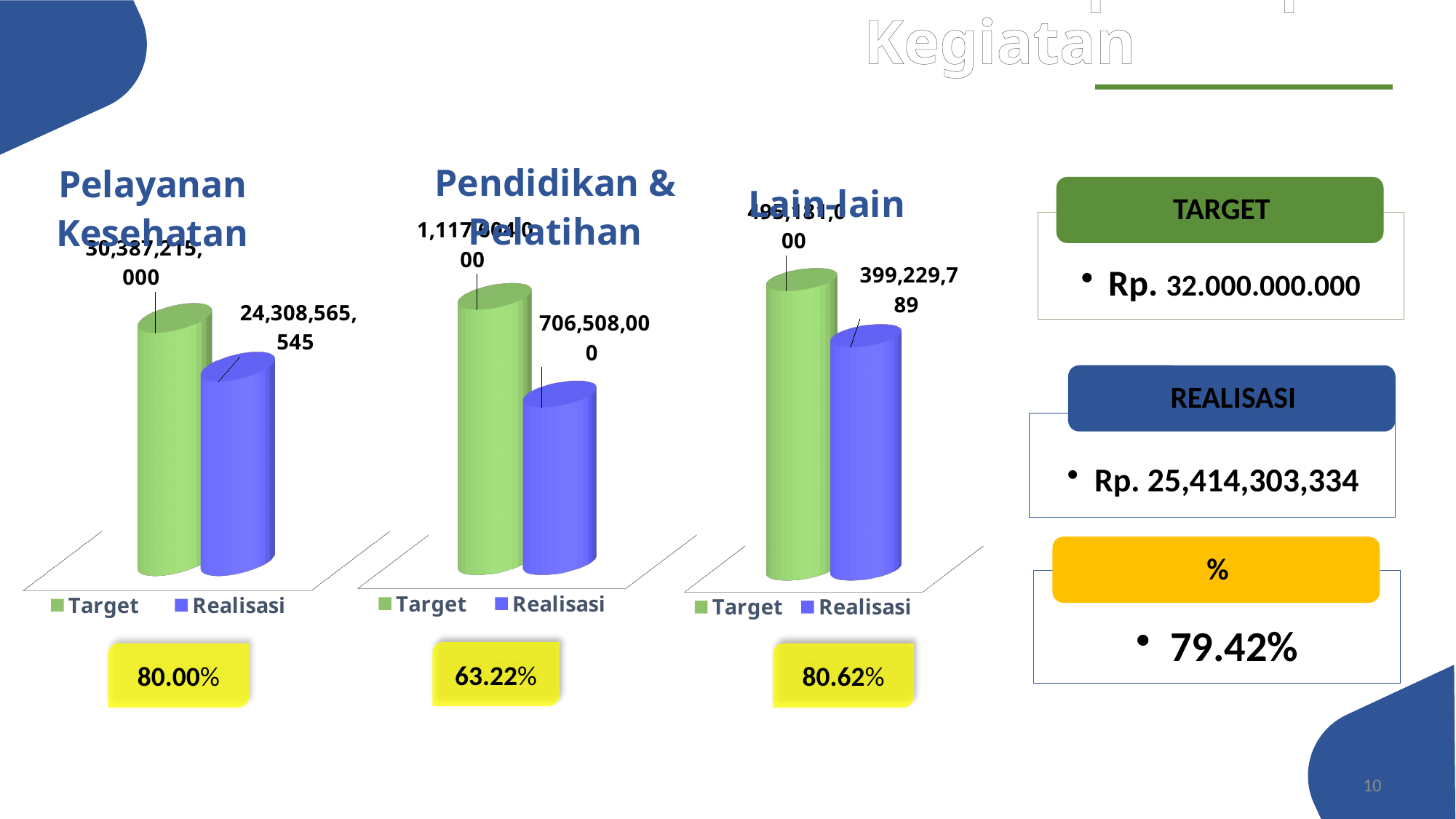
What are the two legend entries in the Pendidikan & Pelatihan chart? Target and Realisasi In the Pendidikan & Pelatihan chart, which bar is taller, Target or Realisasi? Target In the Lain-lain chart, what is the value of the Realisasi bar? 399,229,789 In the Pelayanan Kesehatan chart, what is the difference between the Target and Realisasi values? 6,078,649,455 What kind of chart is the Lain-lain chart? Bar chart In the Pelayanan Kesehatan chart, what is the value of the Target bar? 30,387,215,000 In the Pelayanan Kesehatan chart, which is larger, Target or Realisasi? Target In the Lain-lain chart, which is larger, Target or Realisasi? Target In the Pendidikan & Pelatihan chart, what is the value of the Realisasi bar? 706,508,000 How many series does the legend of the Pelayanan Kesehatan chart list? 2 In the Pelayanan Kesehatan chart, what is the value of the Realisasi bar? 24,308,565,545 In the Pelayanan Kesehatan chart, what colour are the Target bars? Green